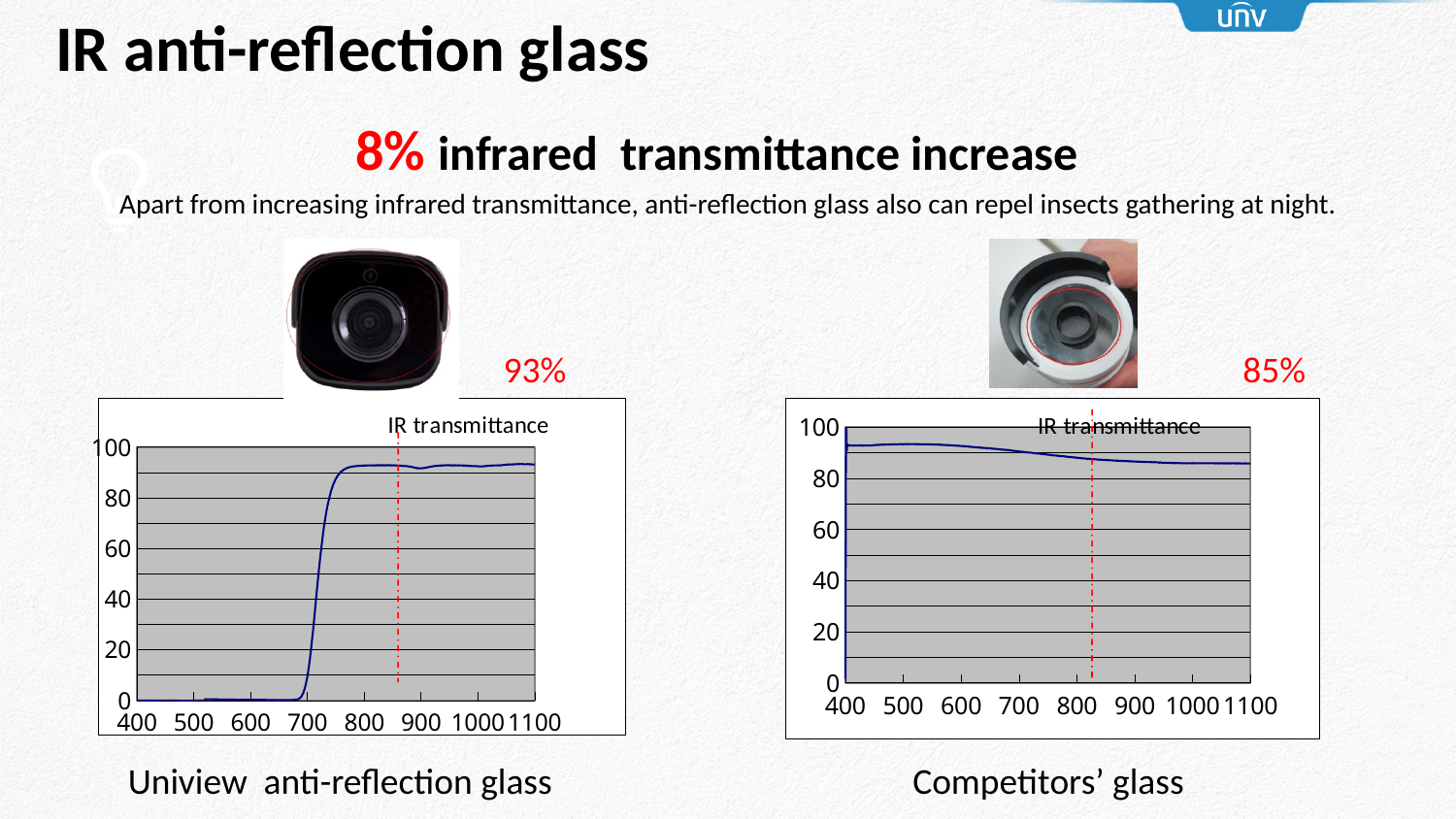
In the right chart (Competitors' glass), is the value at 500 greater or less than 80? greater What IR transmittance percentage is annotated above the left chart for Uniview anti-reflection glass? 93% In the right chart (Competitors' glass), does the line rise or fall between 500 and 1100 on the x axis? fall In the left chart (Uniview anti-reflection glass), does the line rise or fall between 600 and 800 on the x axis? rise What is the difference between the annotated IR transmittance of Uniview anti-reflection glass (93%) and Competitors' glass (85%)? 8% Which glass has the higher annotated IR transmittance, Uniview anti-reflection glass or Competitors' glass? Uniview anti-reflection glass What type of chart is the left chart (Uniview anti-reflection glass)? line chart In the left chart (Uniview anti-reflection glass), is the value at 500 greater or less than 20? less In the left chart (Uniview anti-reflection glass), is the value at 900 greater or less than 80? greater What IR transmittance percentage is annotated above the right chart for Competitors' glass? 85% What type of chart is the right chart (Competitors' glass)? line chart What is the title of the left chart (Uniview anti-reflection glass)? IR transmittance